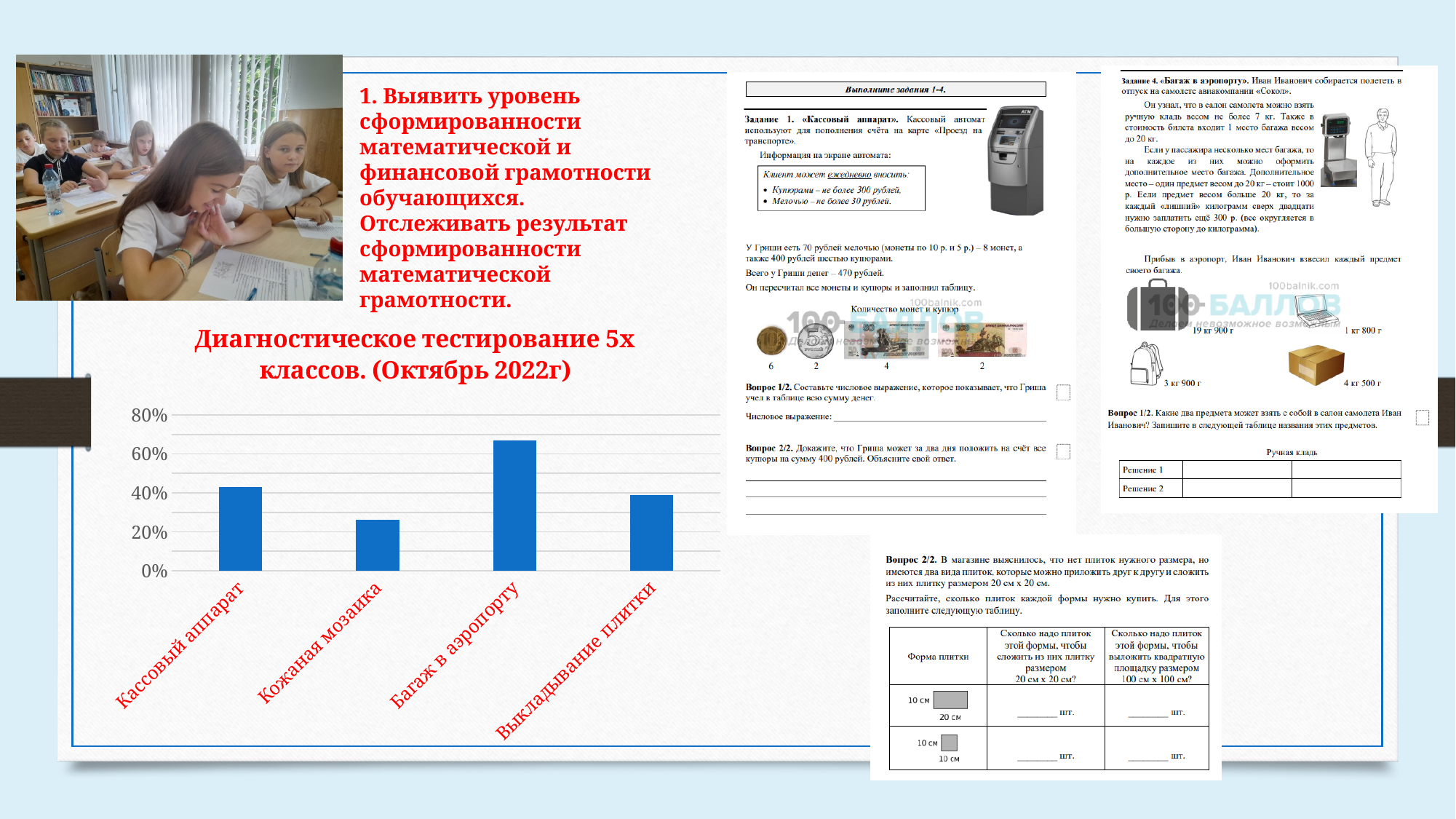
Is the value for Кожаная мозаика greater or less than 40%? less Which is larger, the value for Кассовый аппарат or the value for Кожаная мозаика? Кассовый аппарат Does the value rise or fall from Кожаная мозаика to Багаж в аэропорту? rise Is the value for Кассовый аппарат greater or less than 20%? greater What kind of chart is shown on the slide? bar chart Which category has the lowest value on the chart? Кожаная мозаика How many categories are shown on the bar chart? 4 Is the value for Багаж в аэропорту greater or less than 60%? greater Which is larger, the value for Багаж в аэропорту or the value for Выкладывание плитки? Багаж в аэропорту Which category has the highest value on the chart? Багаж в аэропорту What is the title shown above the bar chart? Диагностическое тестирование 5х классов. (Октябрь 2022г)